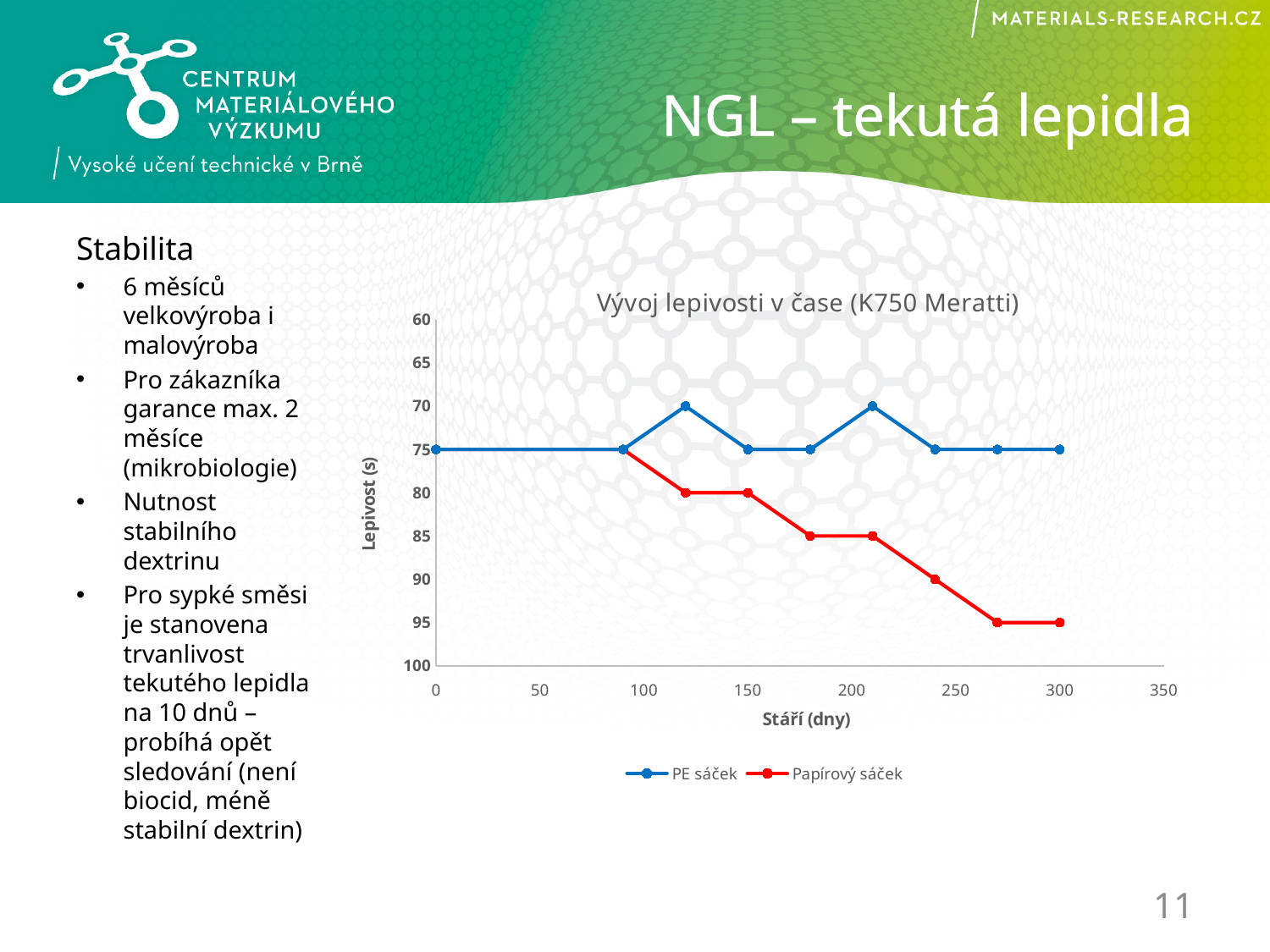
Do the plotted Lepivost (s) values for Papírový sáček increase or decrease numerically as the age in days increases? increase What is the Lepivost (s) value for PE sáček at 300 days? 75 What is the Lepivost (s) value for Papírový sáček at 150 days? 80 What kind of chart is shown on the slide? line chart What is the title of the chart? Vývoj lepivosti v čase (K750 Meratti) At 300 days, which series has the larger Lepivost (s) value, PE sáček or Papírový sáček? Papírový sáček How many data points are plotted for the Papírový sáček series? 9 What is the label of the x axis of the chart? Stáří (dny) What is the Lepivost (s) value for Papírový sáček at 300 days? 95 What is the Lepivost (s) value for both series at 0 days? 75 How many series does the chart legend list? 2 What is the difference between the Papírový sáček and PE sáček values at 300 days? 20